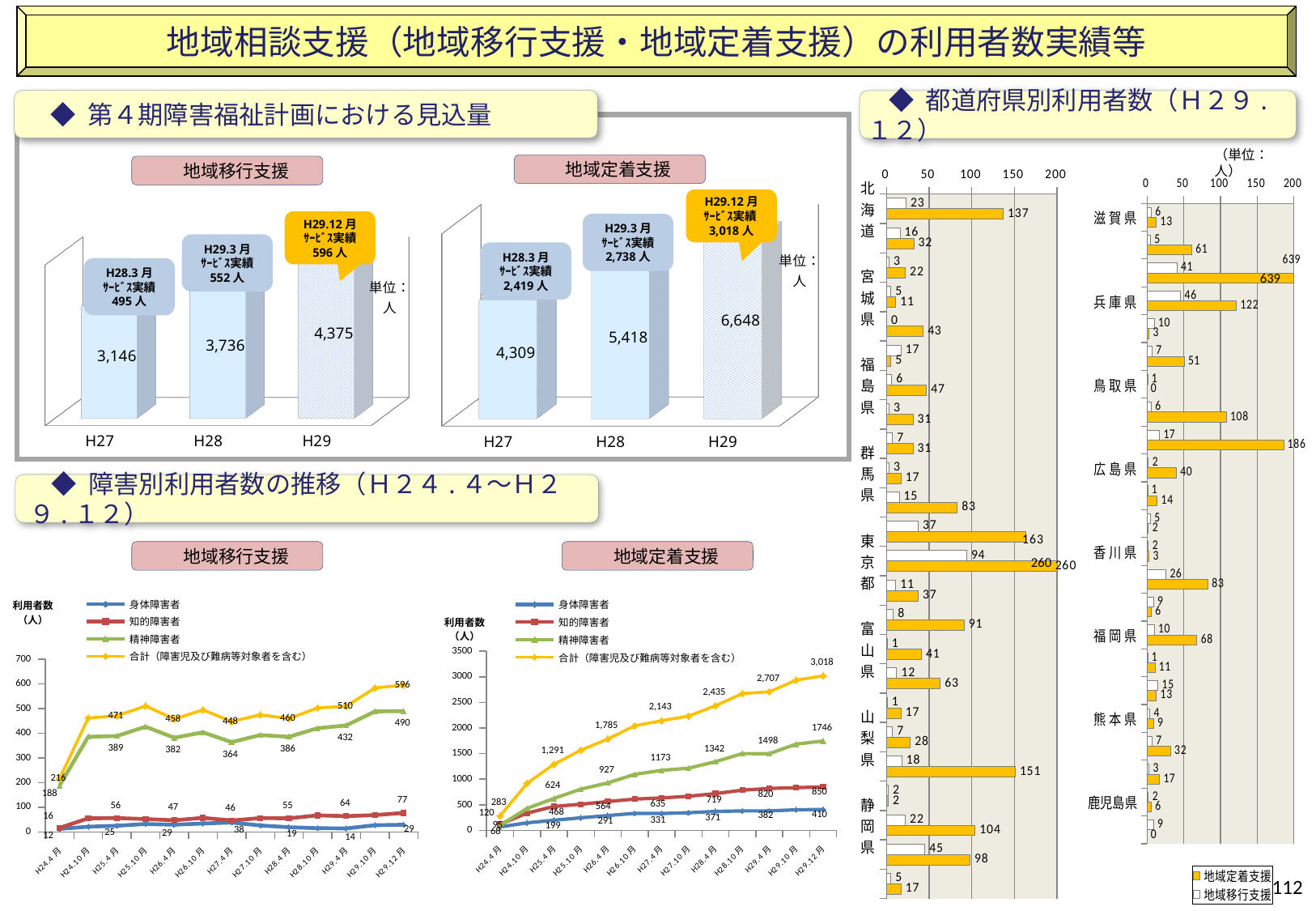
In the 地域移行支援 bar chart under 第４期障害福祉計画における見込量, what is the H29.12月 サービス実績 shown in the callout? 596人 In the 地域定着支援 bar chart under 第４期障害福祉計画における見込量, what is the value for H28? 5,418 How many series does the legend list in the 地域移行支援 line chart under 障害別利用者数の推移? 4 In the 地域移行支援 line chart under 障害別利用者数の推移, which series has the highest value at H29.12月? 合計（障害児及び難病等対象者を含む） In the 地域定着支援 line chart under 障害別利用者数の推移, what is the 合計 value at H29.12月? 3,018 In the 地域定着支援 bar chart under 第４期障害福祉計画における見込量, what is the difference between the H29 and H27 values? 2,339 How many series does the legend list in the 都道府県別利用者数（Ｈ２９．１２） chart? 2 In the 地域定着支援 line chart under 障害別利用者数の推移, what is the 精神障害者 value at H29.12月? 1746 In the 地域移行支援 bar chart under 第４期障害福祉計画における見込量, do the values rise or fall from H27 to H29? rise How many categories are shown on the x axis of the 地域定着支援 bar chart under 第４期障害福祉計画における見込量? 3 What kind of chart is the 地域移行支援 chart under 障害別利用者数の推移? line chart In the 地域移行支援 bar chart under 第４期障害福祉計画における見込量, what is the value for H29? 4,375